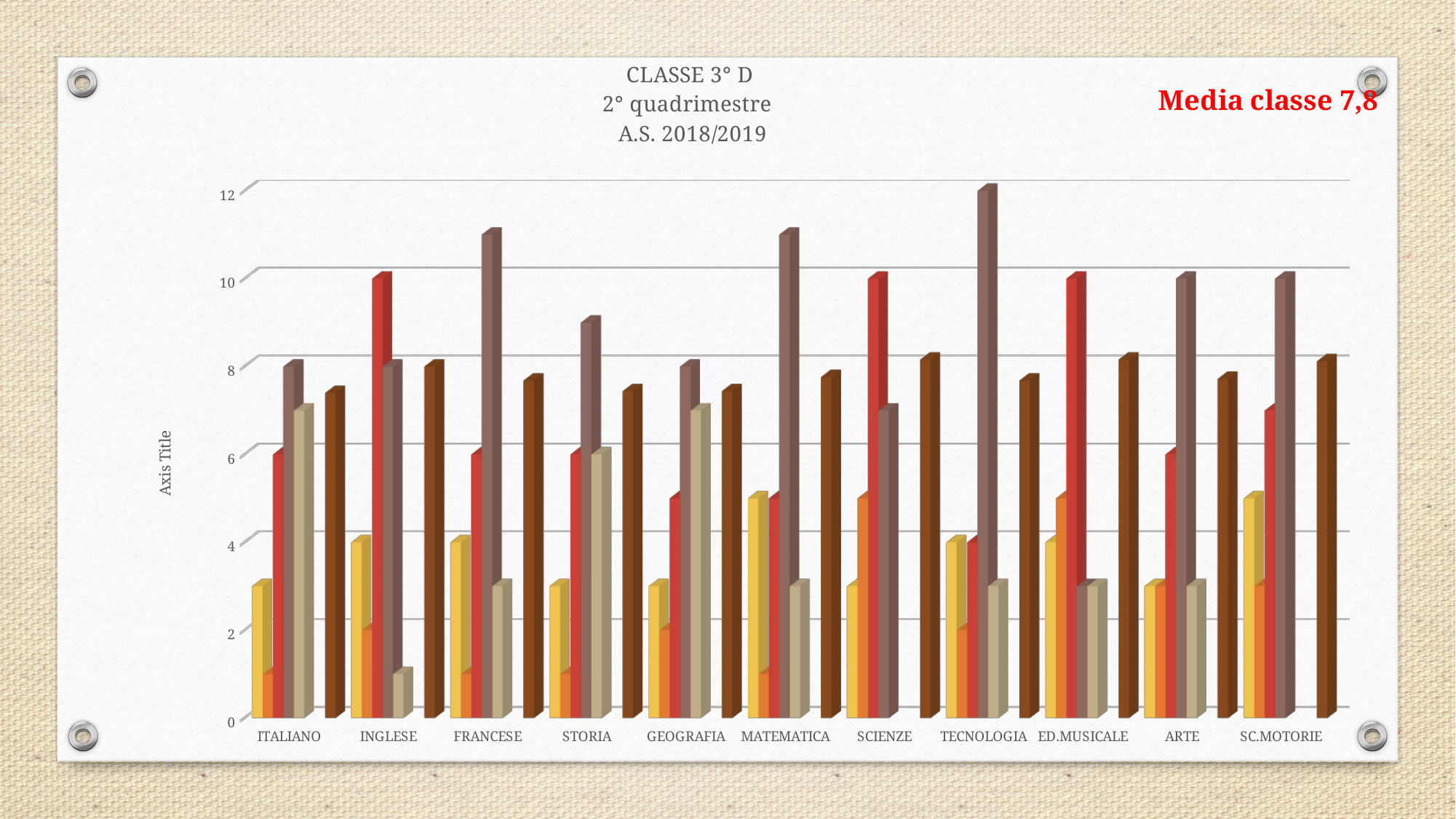
How many subject categories are shown along the x axis? 11 Is the tallest bar for TECNOLOGIA greater or less than 10? greater Which category contains the tallest bar in the chart? TECNOLOGIA What class average (Media classe) is written in red on the slide? 7,8 Is the red bar for INGLESE greater or less than 8? greater What kind of chart is shown on the slide? bar chart Which category has the taller maximum bar, TECNOLOGIA or ITALIANO? TECNOLOGIA Is the tallest bar for ITALIANO greater or less than 10? less What is the title of the chart? CLASSE 3° D 2° quadrimestre A.S. 2018/2019